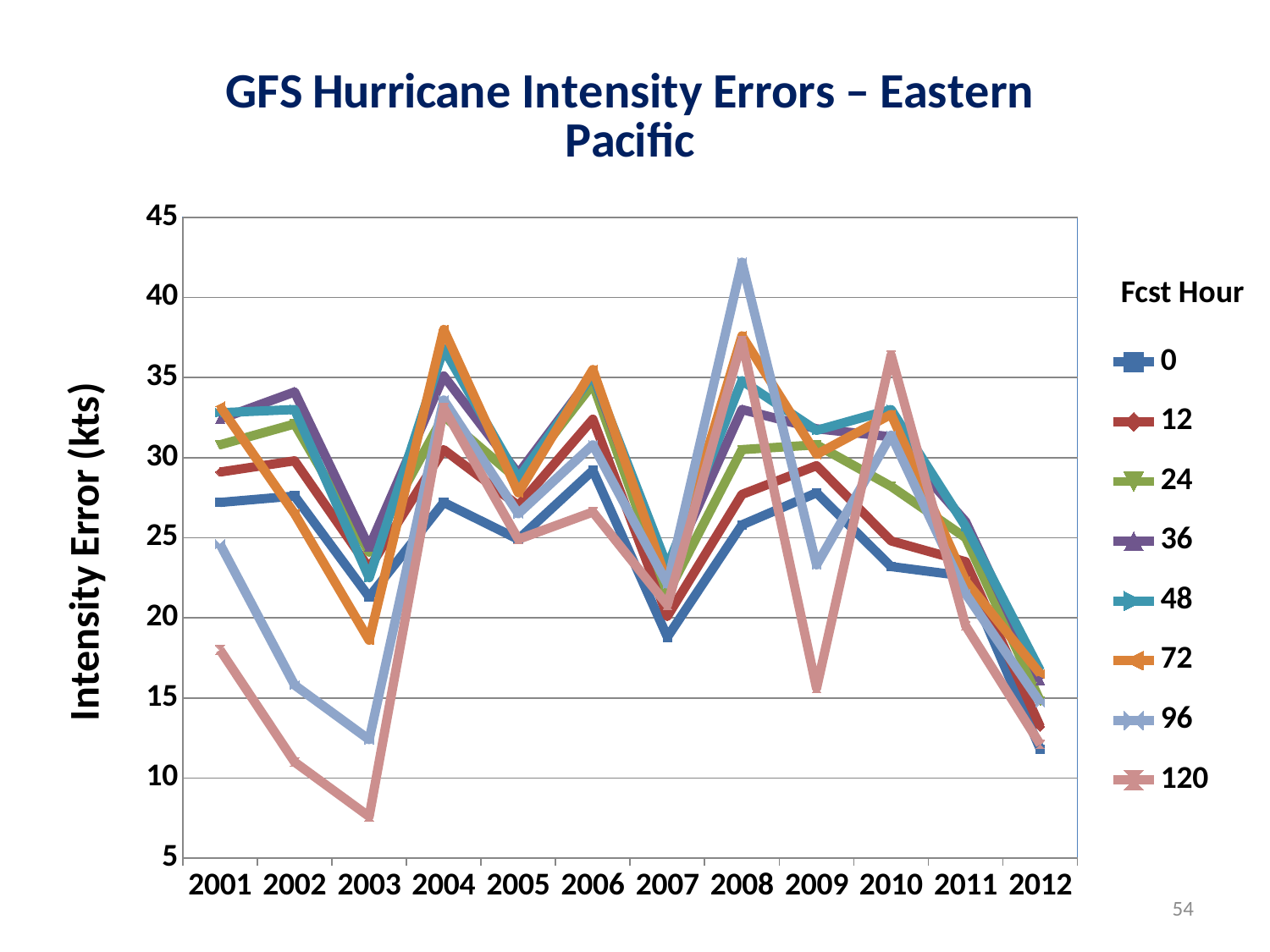
Is the value for the 72 forecast hour series in 2004 greater or less than 35? greater What kind of chart is shown on the slide? line chart Is the value for the 0 forecast hour series in 2007 greater or less than 20? less Is the value for the 120 forecast hour series in 2003 greater or less than 10? less How many series does the legend list? 8 Does the 0 forecast hour series rise or fall from 2010 to 2012? fall In 2008, which series has the larger value: 96 or 0? 96 How many years are shown along the x axis? 12 In which year does the 120 forecast hour series reach its lowest value? 2003 What is the title of the legend? Fcst Hour In which year does the 96 forecast hour series reach its highest value? 2008